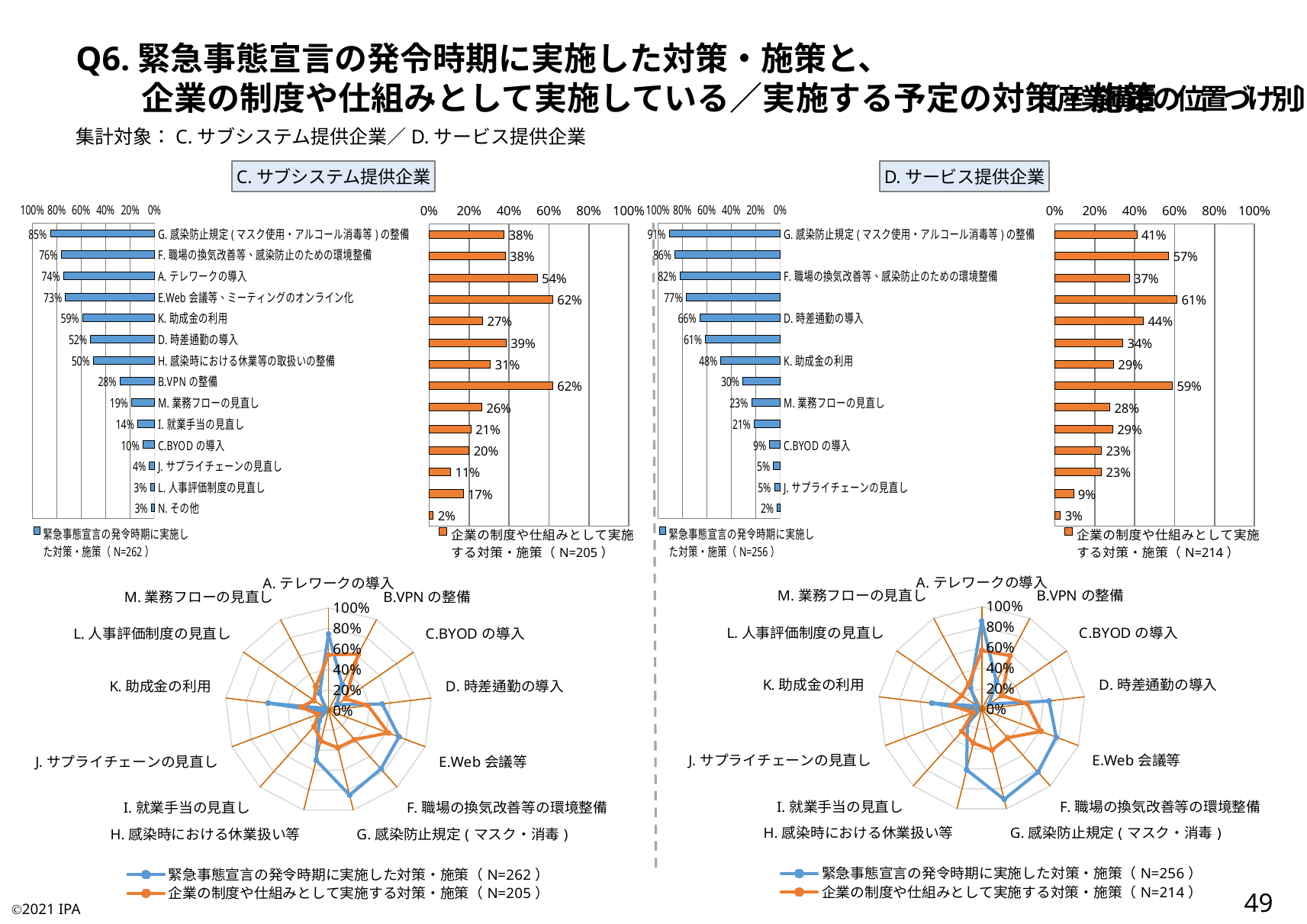
What kind of chart is used at the bottom of the slide for each company group? Radar chart In the C. サブシステム提供企業 bar chart, which has the larger blue-series value: K. 助成金の利用 or D. 時差通勤の導入? K. 助成金の利用 In the C. サブシステム提供企業 bar chart, which category has the lowest value in the orange series? N. その他 In the C. サブシステム提供企業 bar chart, what is the value for A. テレワークの導入 in the orange series (企業の制度や仕組みとして実施する対策・施策)? 54% In the D. サービス提供企業 bar chart, what is the orange-series value for D. 時差通勤の導入? 44% In the C. サブシステム提供企業 bar chart, what percentage of companies implemented G. 感染防止規定 during the emergency declaration period (blue series)? 85% In the C. サブシステム提供企業 bar chart, which category has the highest value in the blue series? G. 感染防止規定 In the C. サブシステム提供企業 bar chart, what is the difference between the blue value (85%) and the orange value (38%) for G. 感染防止規定? 47 percentage points How many series does the legend of the left radar chart list? 2 How many categories are shown in the C. サブシステム提供企業 bar chart? 14 In the D. サービス提供企業 bar chart, what is the blue-series value for K. 助成金の利用? 48% In the D. サービス提供企業 bar chart, what is the blue-series value for G. 感染防止規定? 91%